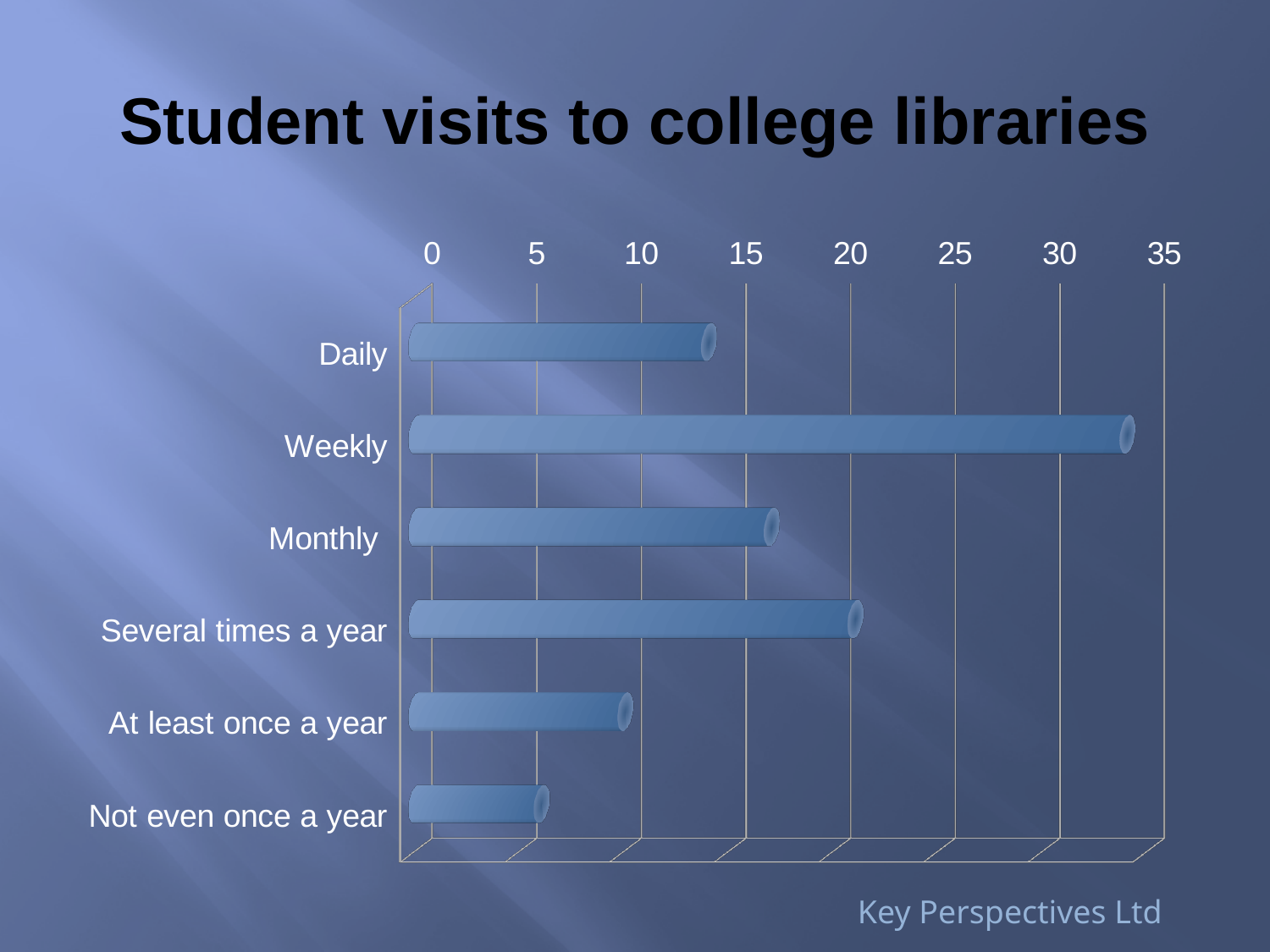
Which category has the lowest value? Not even once a year Which category has the highest value? Weekly Is the value for Daily greater or less than 15? less What is the title of the chart? Student visits to college libraries What kind of chart is shown on the slide? bar chart Is the value for Not even once a year greater or less than 10? less Is the value for Several times a year greater or less than 15? greater Which is larger, the value for Monthly or the value for Daily? Monthly How many categories are plotted in the chart? 6 Which is larger, the value for Several times a year or the value for At least once a year? Several times a year